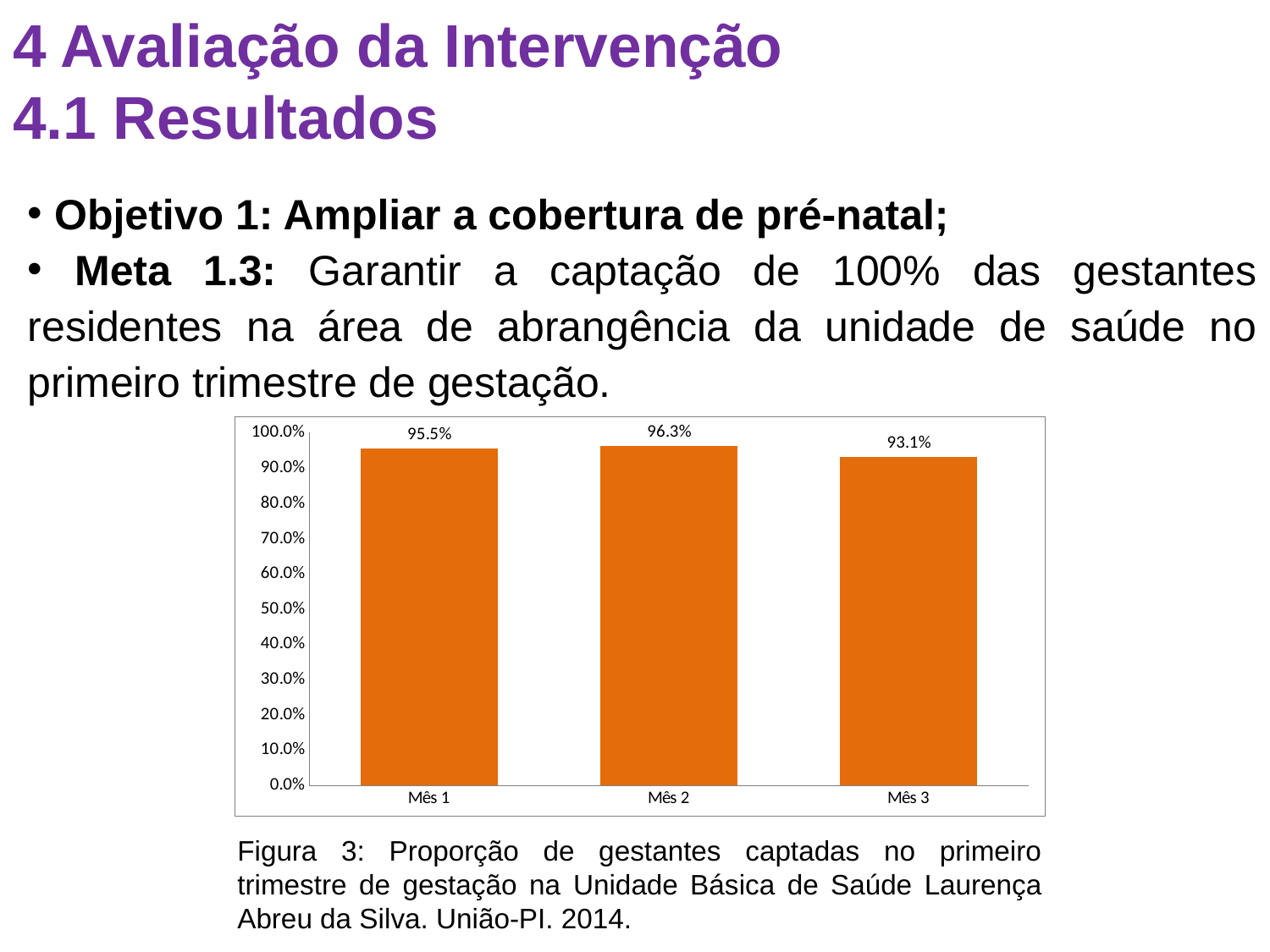
What is the difference between the values for Mês 2 and Mês 1? 0.8% Is the value for Mês 3 greater or less than 90.0%? greater What is the value for Mês 3? 93.1% How many months are shown on the x axis? 3 What is the maximum value shown on the y axis? 100.0% What is the value for Mês 2? 96.3% Which is larger, the value for Mês 1 or the value for Mês 3? Mês 1 Which month has the highest value? Mês 2 What is the difference between the values for Mês 2 and Mês 3? 3.2% What kind of chart is shown on the slide? bar chart Which month has the lowest value? Mês 3 What is the value for Mês 1? 95.5%